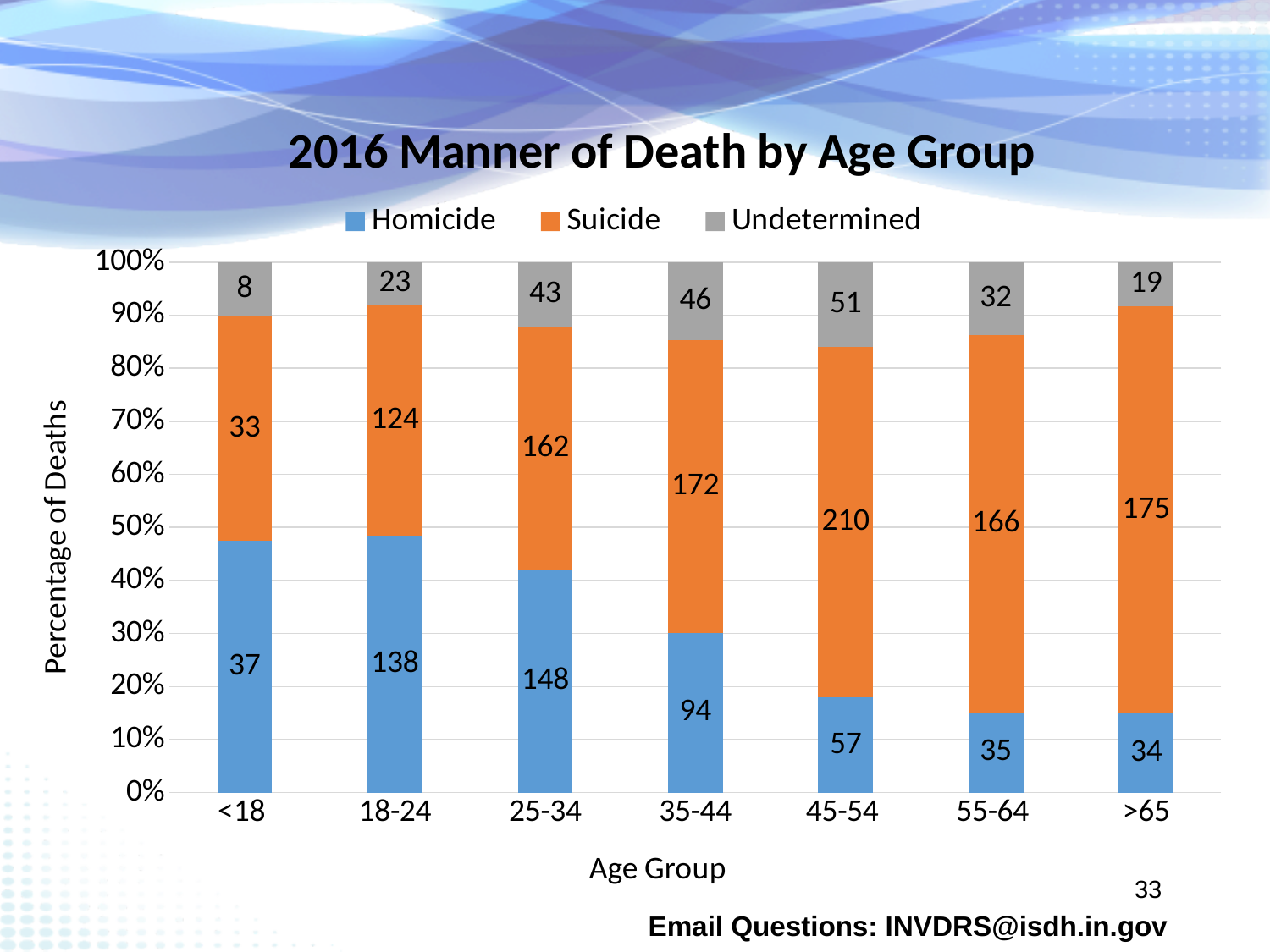
Which age group has the lowest Undetermined value? <18 What is the difference between the Suicide values for the 35-44 and 25-34 age groups? 10 Which is larger, the Homicide value for 18-24 or the Homicide value for 25-34? 25-34 What is the Suicide value for the >65 age group? 175 What is the title of the chart? 2016 Manner of Death by Age Group How many series does the legend list? 3 What kind of chart is shown on the slide? Stacked bar chart How many age groups are shown on the x axis? 7 Which age group has the highest Suicide value? 45-54 What is the total of the three labelled values in the <18 bar? 78 What is the Homicide value for the 25-34 age group? 148 What is the Undetermined value for the 45-54 age group? 51